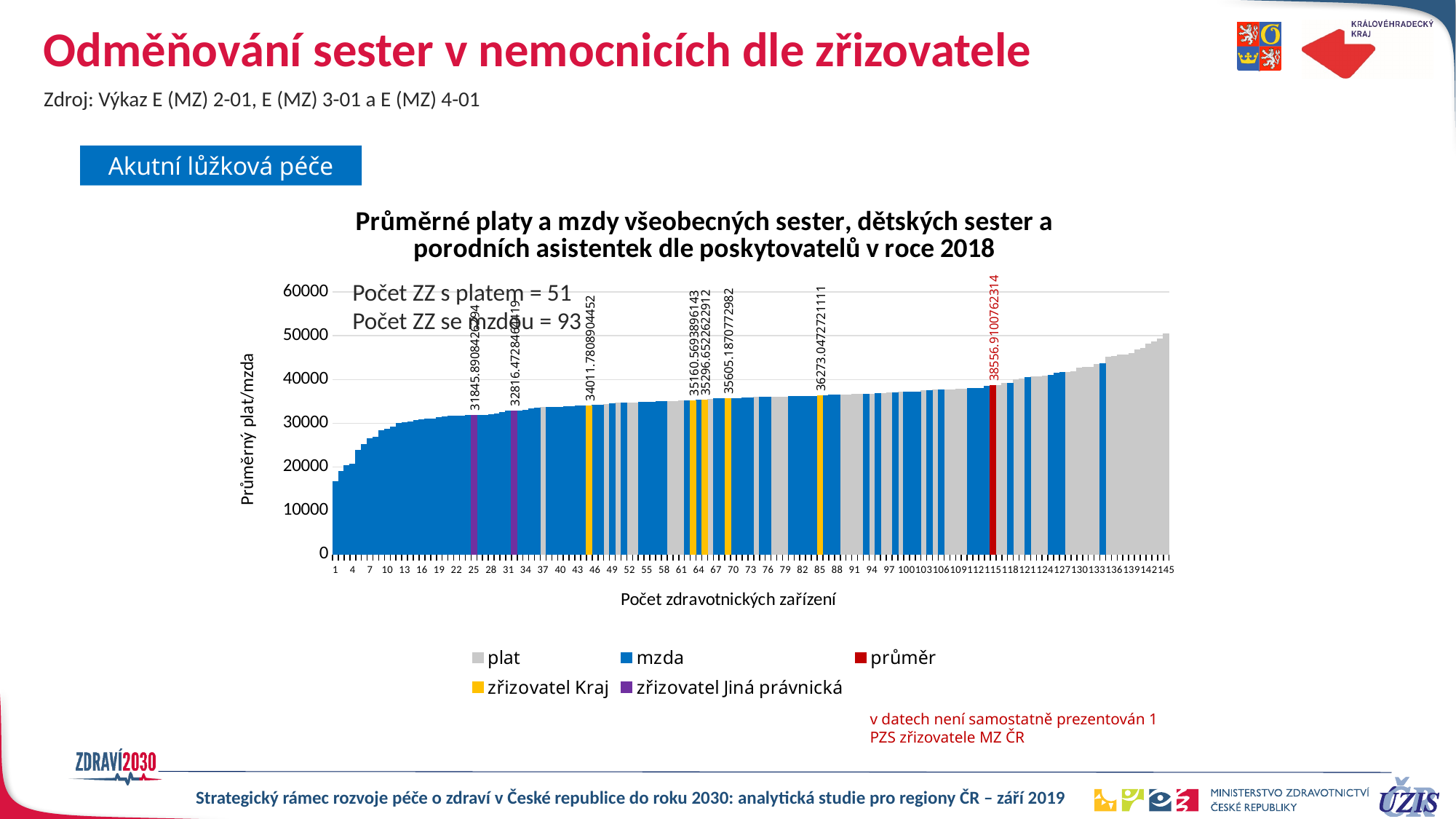
Is the value for provider 1 greater or less than 20000? less How many series does the legend list? 5 According to the text on the chart, how many ZZ have 'plat' (Počet ZZ s platem)? 51 What value is printed on the yellow 'zřizovatel Kraj' bar at position 85 on the x axis? 36273.0472721111 What value is printed on the yellow bar at position 69 on the x axis? 35605.1870772982 What is the difference between the 'průměr' value (38556.9100762314) and the value 36273.0472721111? 2283.8628041203 What value is printed on the yellow bar at position 45 on the x axis? 34011.7808904452 What value is printed on the red 'průměr' bar? 38556.9100762314 Do the bar values rise or fall from left to right along the x axis? rise Which is larger: the 'průměr' bar or the bar labelled 34011.7808904452? průměr What kind of chart is shown on the slide? bar chart What is the label of the x axis? Počet zdravotnických zařízení